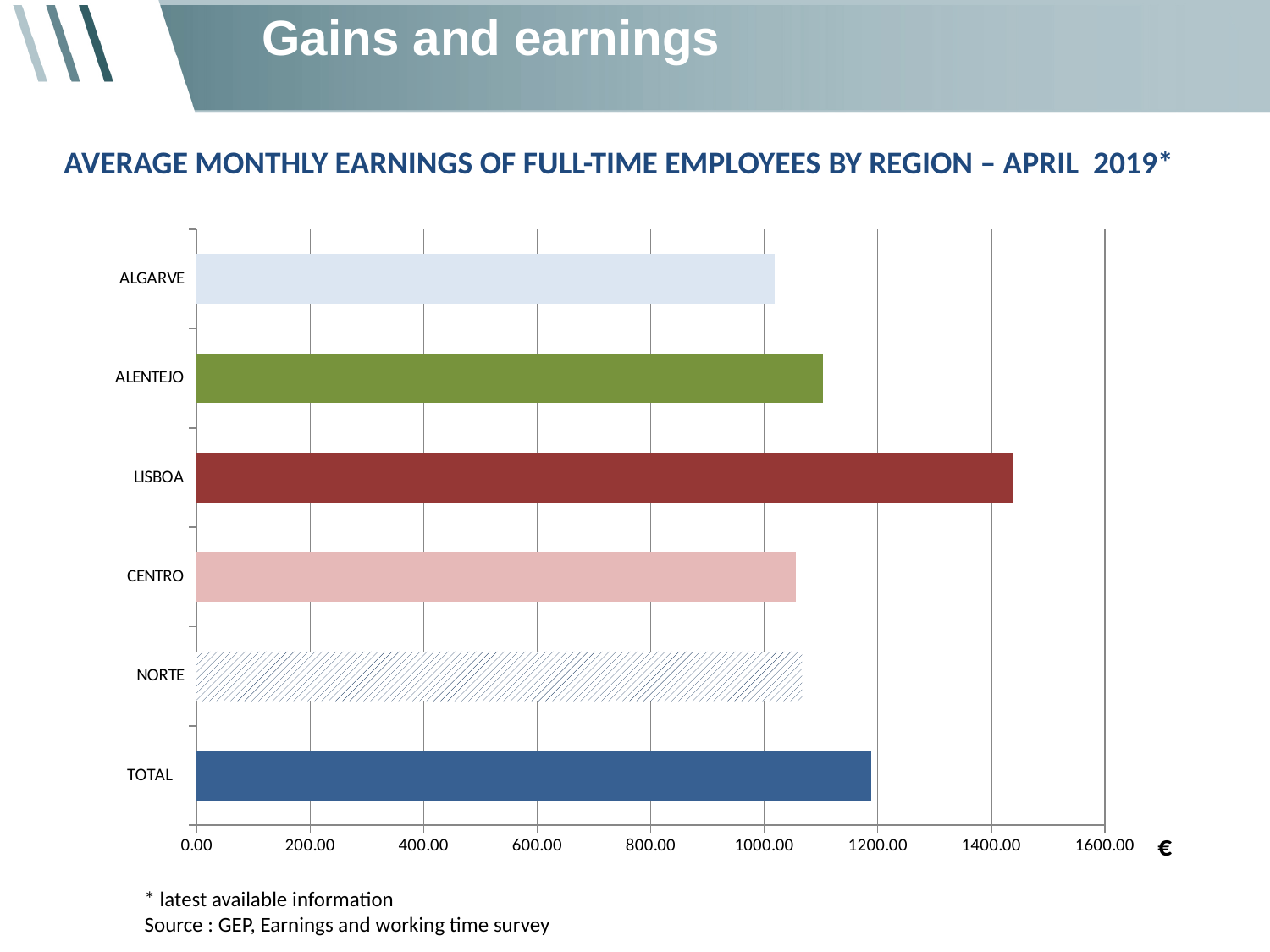
What kind of chart is shown on the slide? bar chart Which region has the highest average monthly earnings in the chart? LISBOA Is the value for LISBOA greater or less than 1400.00? greater Is the value for CENTRO greater or less than 1200.00? less How many categories (bars) are shown in the chart? 6 Is the value for NORTE greater or less than 1200.00? less What is the title of the chart? AVERAGE MONTHLY EARNINGS OF FULL-TIME EMPLOYEES BY REGION – APRIL 2019* What currency symbol is shown at the end of the horizontal axis? € Which is larger, the value for LISBOA or the value for TOTAL? LISBOA Which is larger, the value for ALENTEJO or the value for ALGARVE? ALENTEJO